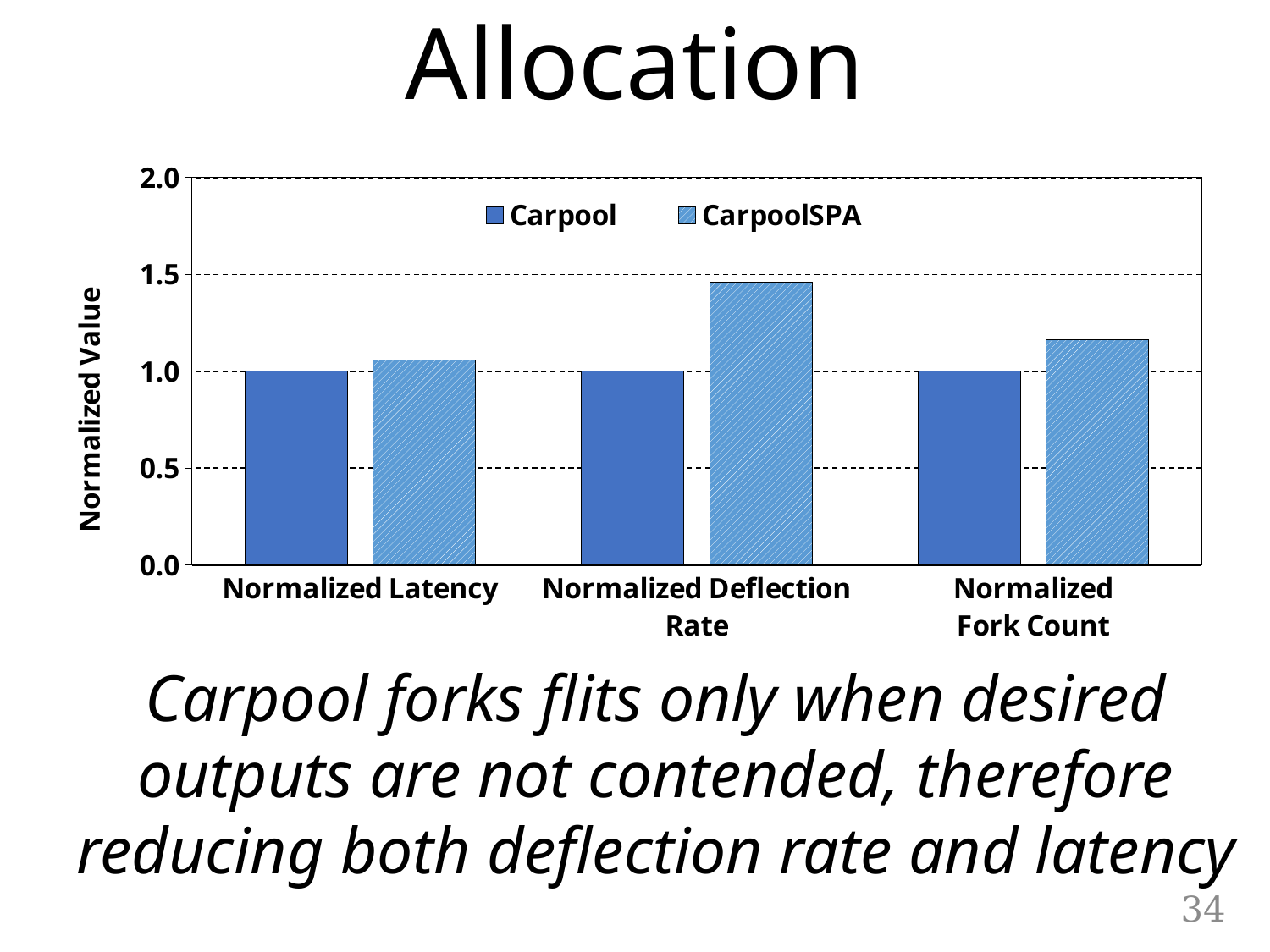
What kind of chart is shown on the slide? bar chart What is the title of the y axis? Normalized Value Which category has the highest CarpoolSPA value? Normalized Deflection Rate How many categories are shown along the x axis? 3 For Normalized Deflection Rate, which series has the larger value, Carpool or CarpoolSPA? CarpoolSPA Is the CarpoolSPA value for Normalized Deflection Rate greater or less than 1.0? greater How many series does the legend list? 2 What is the Carpool value for Normalized Deflection Rate? 1.0 Which category has the lowest CarpoolSPA value? Normalized Latency What are the two series named in the legend? Carpool and CarpoolSPA What is the Carpool value for Normalized Latency? 1.0 Is the CarpoolSPA value for Normalized Fork Count greater or less than 1.5? less